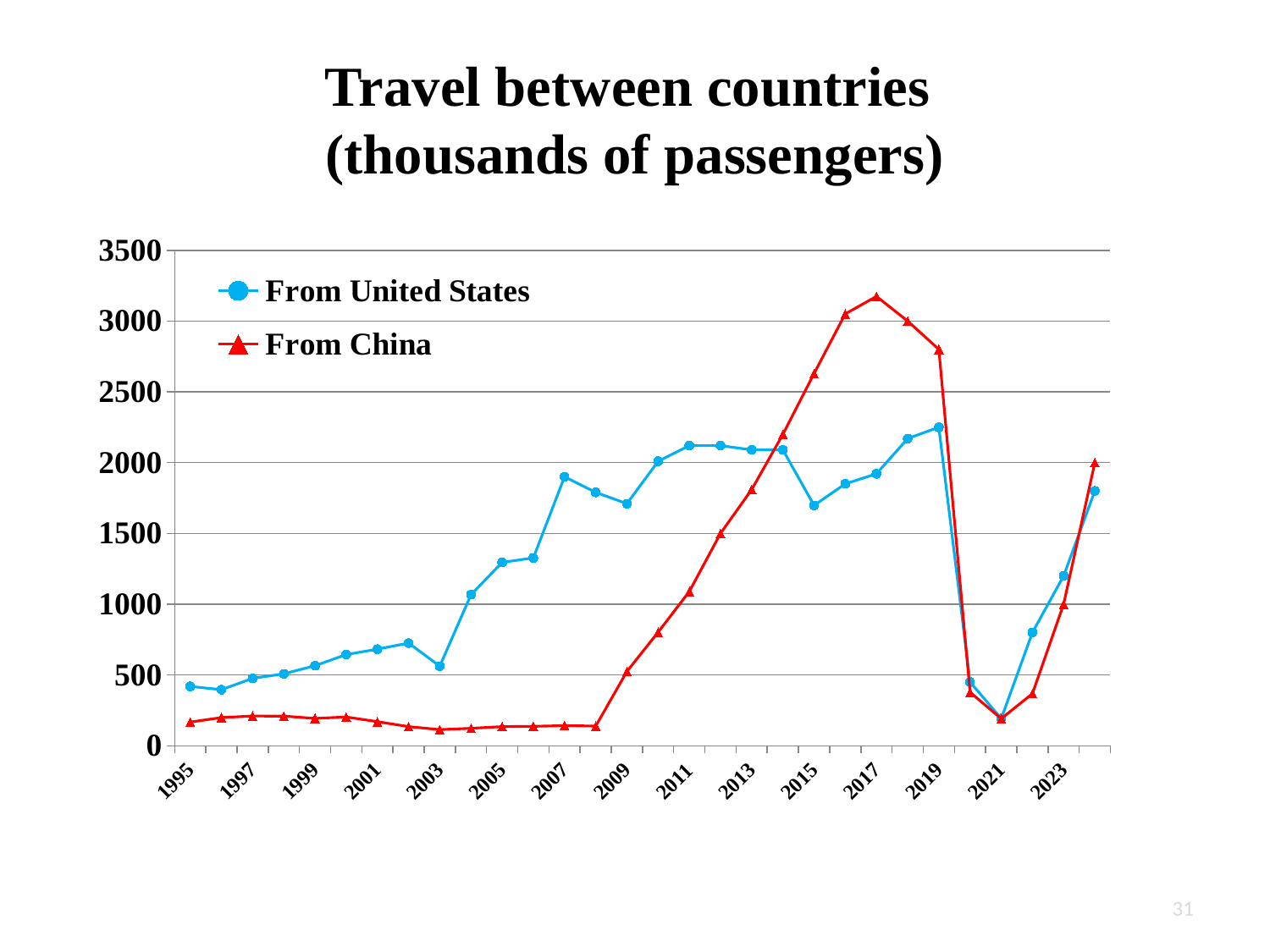
What kind of chart is shown on the slide? line chart What are the two series named in the legend? From United States and From China In 2017, which series has the higher value, From United States or From China? From China Is the value for From United States in 2021 greater or less than 500? less What is the title of the chart? Travel between countries (thousands of passengers) How many series does the legend list? 2 Does the From China series rise or fall between 2009 and 2017? rise Is the value for From China in 2017 greater or less than 3000? greater Is the value for From China in 2003 greater or less than 500? less In which year does the From China series reach its highest value? 2017 In 2007, which series has the higher value, From United States or From China? From United States